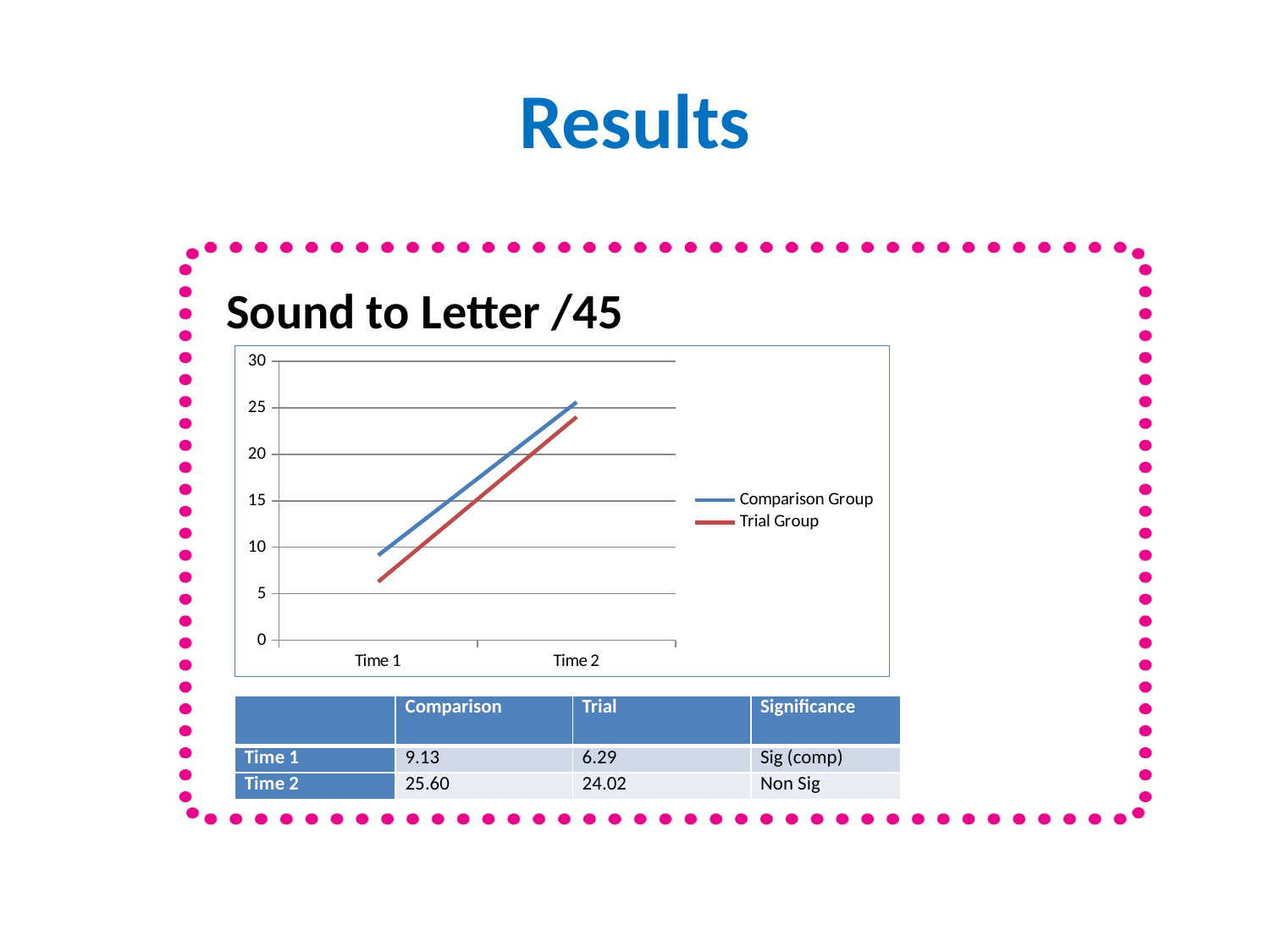
Do the values for the Trial Group rise or fall from Time 1 to Time 2? rise Is the value for the Trial Group at Time 1 greater or less than 10? less What is the value for the Comparison Group at Time 2? 25.60 How many series does the chart's legend list? 2 What is the title shown above the chart? Sound to Letter /45 How many time points are plotted on the x axis of the chart? 2 Is the value for the Comparison Group at Time 2 greater or less than 20? greater What is the value for the Trial Group at Time 2? 24.02 What is the difference between the Comparison Group and Trial Group values at Time 1? 2.84 What is the value for the Comparison Group at Time 1? 9.13 What kind of chart is shown on the slide? line chart Which group has the higher value at Time 1? Comparison Group